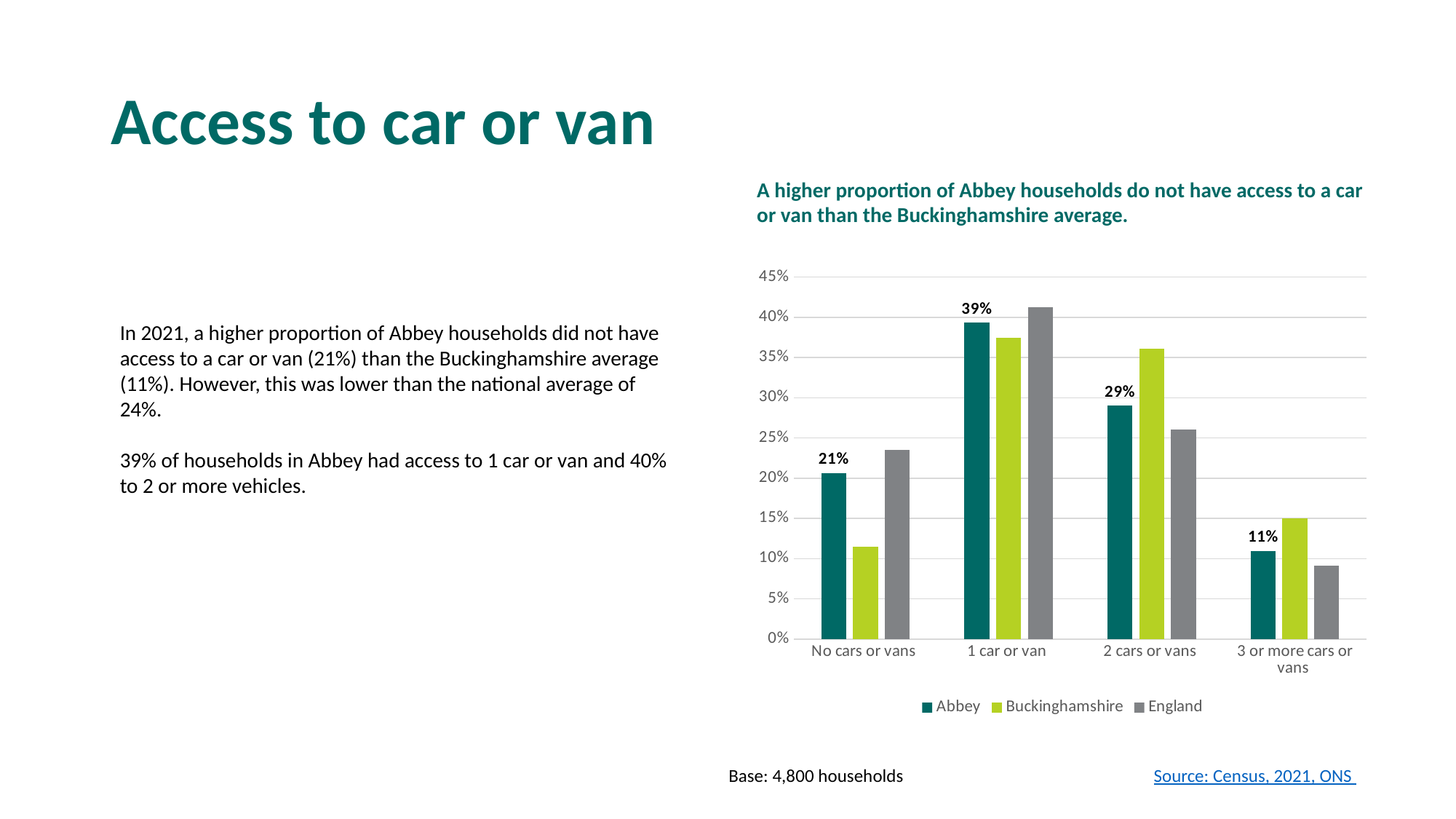
In which category is the Abbey value lowest? 3 or more cars or vans What is the value for Abbey in the '3 or more cars or vans' category? 11% What is the difference between the Abbey values for '1 car or van' and 'No cars or vans'? 18 percentage points What is the value for Abbey in the '2 cars or vans' category? 29% What kind of chart is shown on the slide? Bar chart Is the value for Buckinghamshire in the 'No cars or vans' category greater or less than 15%? less What is the value for Abbey in the '1 car or van' category? 39% How many series does the legend list? 3 In which category is the Abbey value highest? 1 car or van In the 'No cars or vans' category, which is larger: Abbey or Buckinghamshire? Abbey What is the value for Abbey in the 'No cars or vans' category? 21% Is the value for England in the '1 car or van' category greater or less than 40%? greater